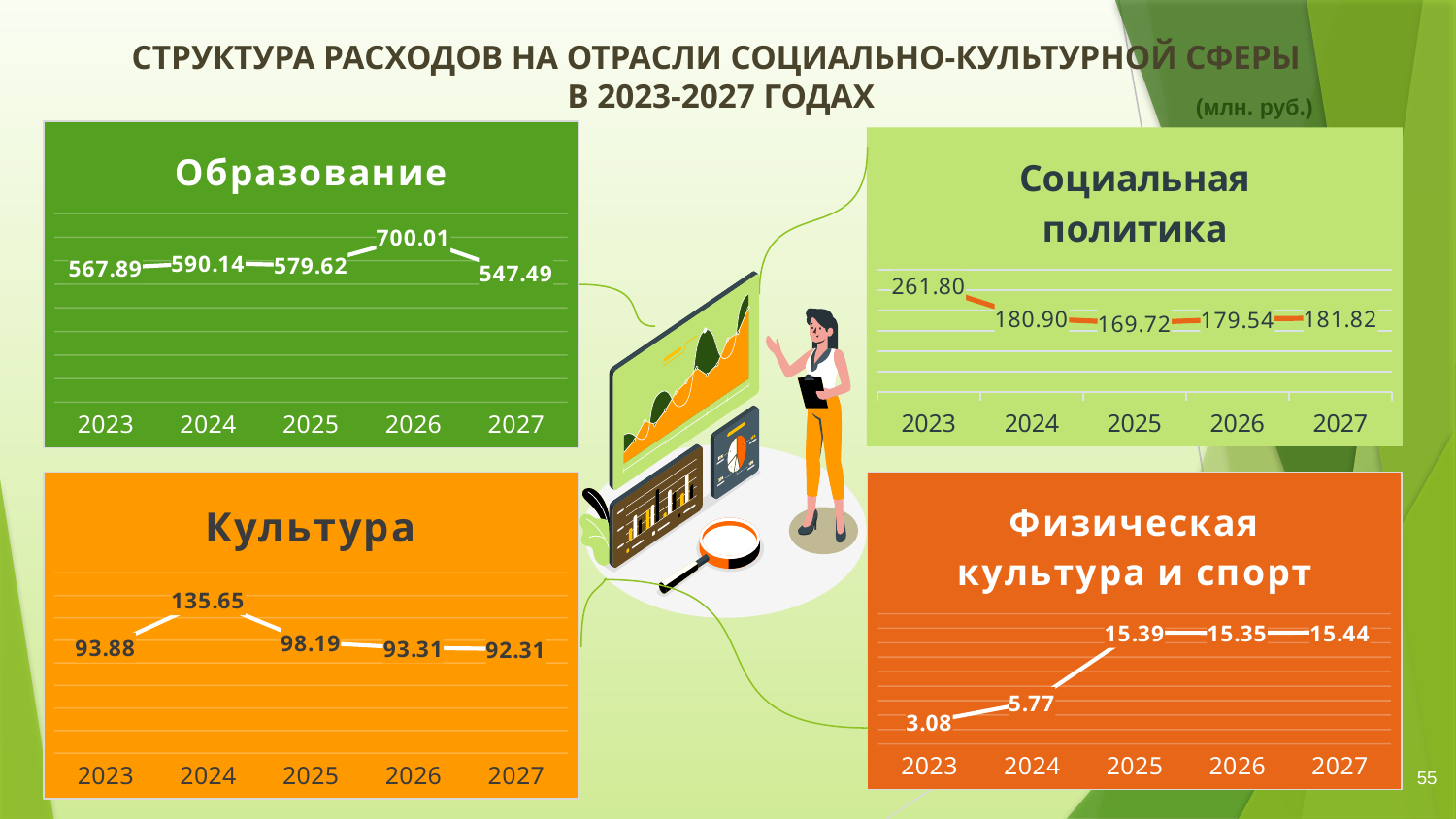
In the "Социальная политика" chart, which year has the lowest value? 2025 In the "Культура" chart, what is the value for 2027? 92.31 In the "Социальная политика" chart, what is the difference between the 2023 and 2024 values? 80.90 In the "Социальная политика" chart, what is the value for 2023? 261.80 In the "Образование" chart, what is the value for 2026? 700.01 In the "Физическая культура и спорт" chart, what is the value for 2023? 3.08 What type of chart is the "Культура" chart? Line chart In the "Физическая культура и спорт" chart, what is the difference between the 2025 and 2024 values? 9.62 In the "Культура" chart, which is larger: the value for 2023 or the value for 2025? 2025 How many years are plotted in the "Образование" chart? 5 In the "Образование" chart, which year has the lowest value? 2027 In the "Культура" chart, which year has the highest value? 2024